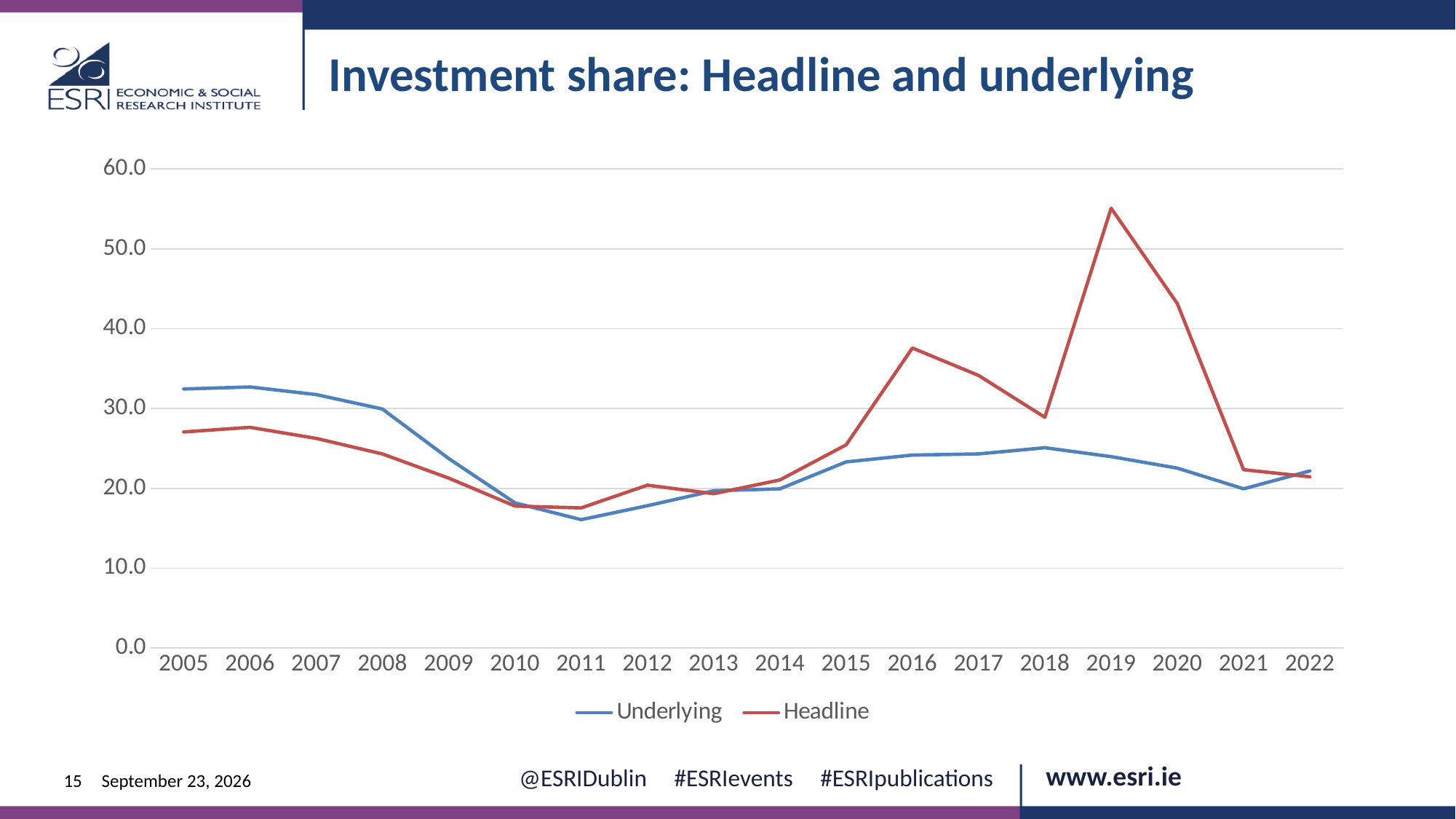
Is the Underlying value for 2011 greater or less than 20.0? less How many years are plotted along the x axis? 18 Is the Headline value for 2016 greater or less than 30.0? greater How many series does the legend list? 2 Does the Underlying series rise or fall between 2006 and 2011? fall Is the Headline value for 2019 greater or less than 50.0? greater What is the title of the chart? Investment share: Headline and underlying In which year does the Headline series reach its highest value? 2019 Which series has the larger value in 2019, Underlying or Headline? Headline Which series has the larger value in 2005, Underlying or Headline? Underlying In which year does the Underlying series reach its lowest value? 2011 What kind of chart is shown on the slide? line chart